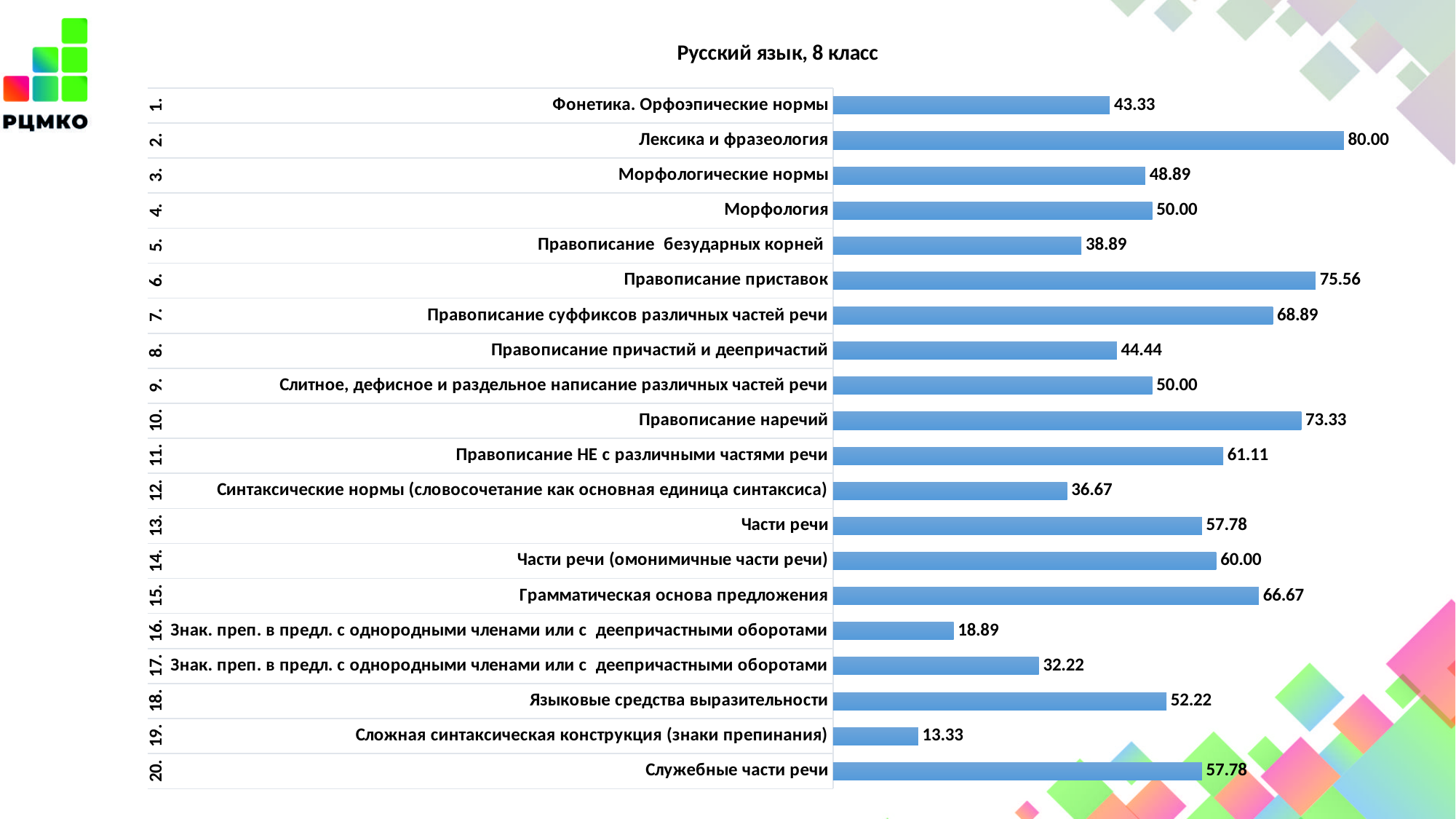
Which category has the lowest value? Сложная синтаксическая конструкция (знаки препинания) Which is larger: the value for "Грамматическая основа предложения" or the value for "Части речи (омонимичные части речи)"? Грамматическая основа предложения What is the value for "Лексика и фразеология"? 80.00 What is the value for "Правописание наречий"? 73.33 What is the title of the chart? Русский язык, 8 класс Which category has the highest value? Лексика и фразеология What is the value for "Языковые средства выразительности"? 52.22 What is the difference between the values for "Правописание приставок" and "Правописание безударных корней"? 36.67 What is the value for row 17 ("Знак. преп. в предл. с однородными членами или с деепричастными оборотами")? 32.22 What is the difference between the values for "Морфология" and "Фонетика. Орфоэпические нормы"? 6.67 What type of chart is shown on the slide? bar chart How many categories (rows) does the chart show? 20